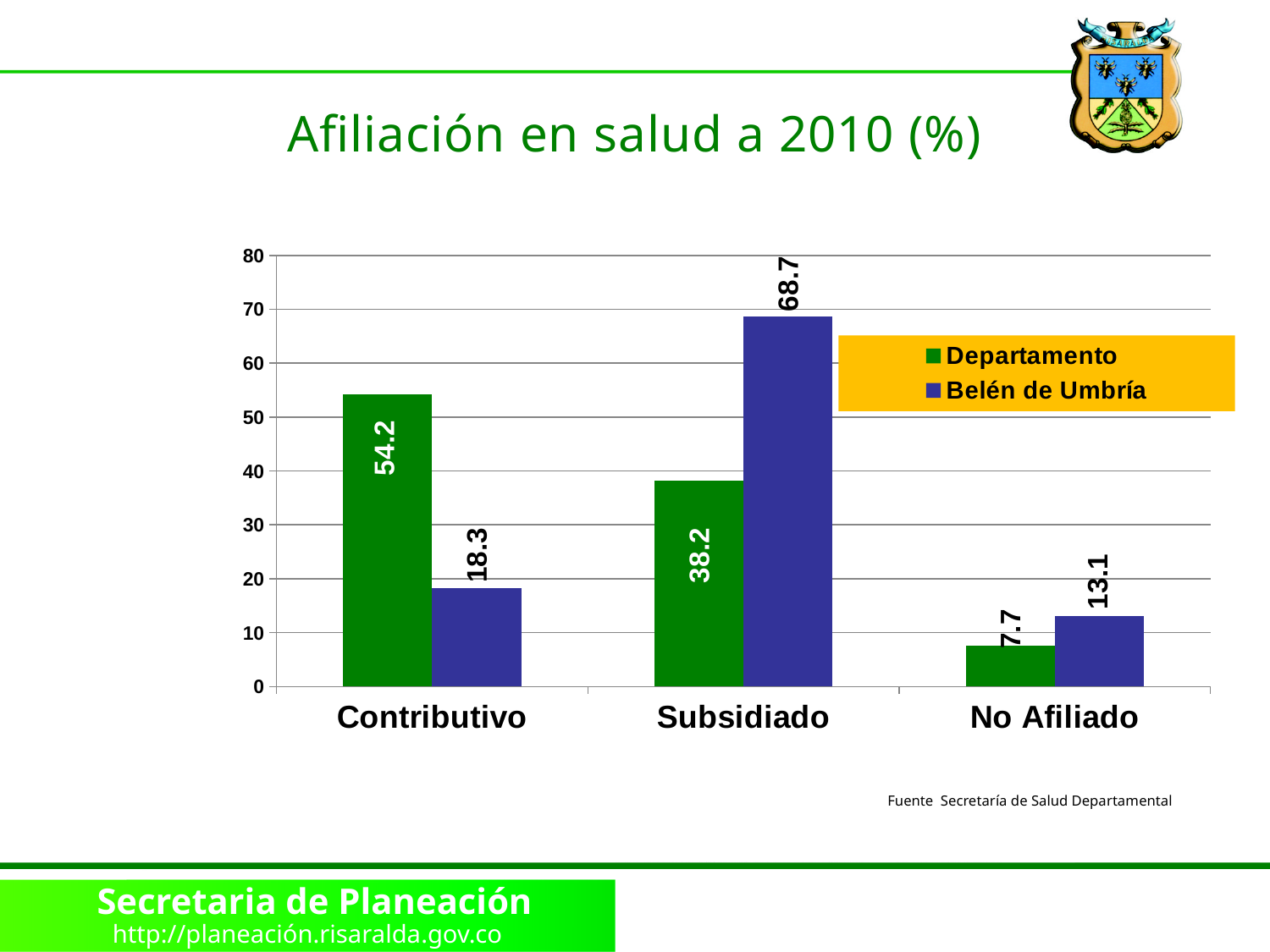
What type of chart is shown on the slide? Bar chart What is the value for Departamento in the No Afiliado category? 7.7 How many categories are shown on the x axis? 3 Is the value for Belén de Umbría in the No Afiliado category greater or less than 10? greater What is the value for Belén de Umbría in the Subsidiado category? 68.7 What is the value for Belén de Umbría in the Contributivo category? 18.3 Which category has the lowest value for Departamento? No Afiliado How many series does the legend list? 2 What is the difference between the Belén de Umbría and Departamento values in the Subsidiado category? 30.5 Which category has the highest value for Belén de Umbría? Subsidiado What is the value for Departamento in the Contributivo category? 54.2 In the Contributivo category, which series has the larger value, Departamento or Belén de Umbría? Departamento